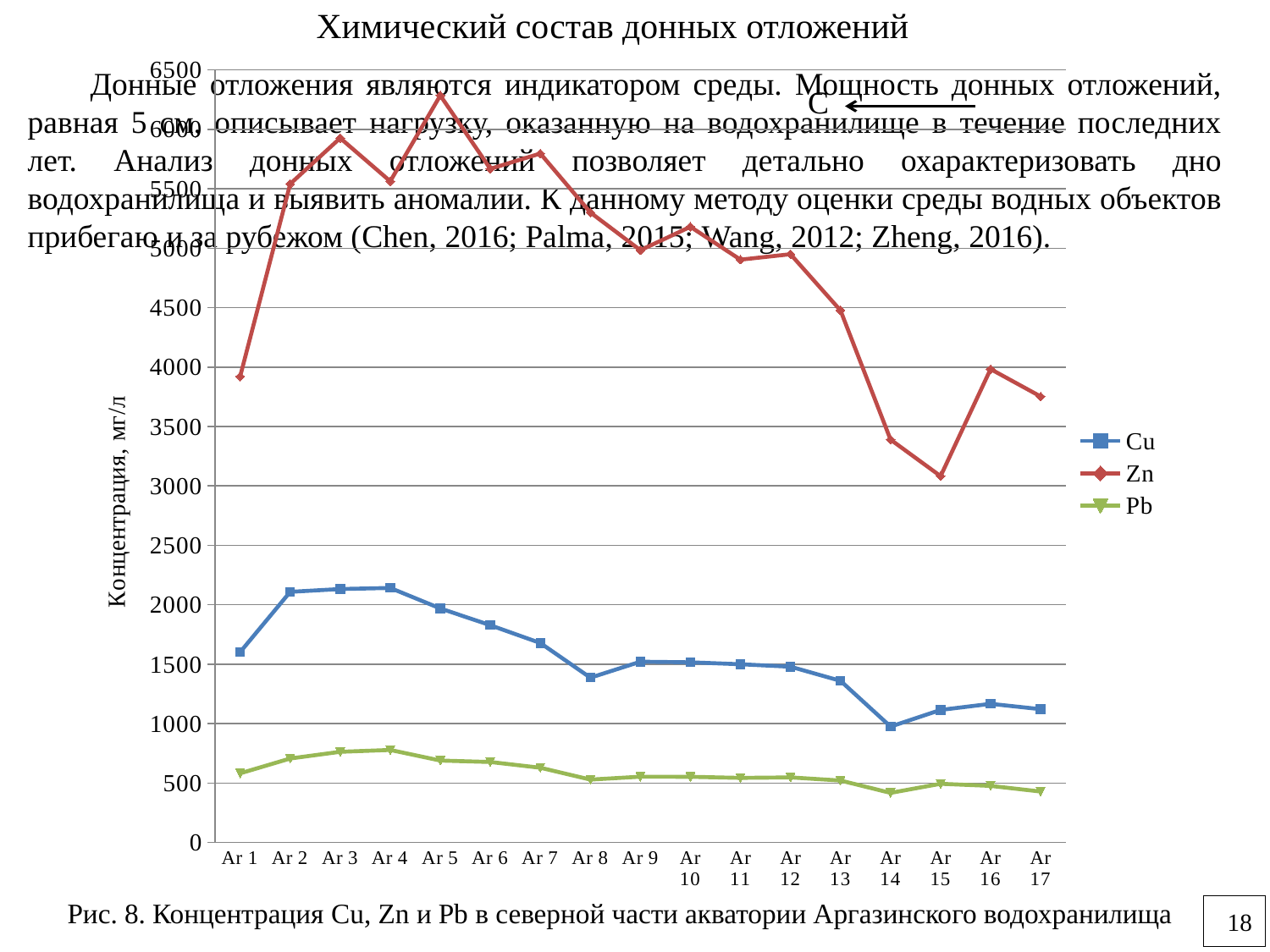
How many series does the legend list? 3 Which sampling point has the lowest Cu concentration? Ar 14 What is the label of the vertical axis? Концентрация, мг/л Which is larger, the Zn value for Ar 2 or the Zn value for Ar 14? Ar 2 How many sampling points (categories) are shown along the x axis? 17 Is the Cu value for Ar 8 greater or less than 1500? less What kind of chart is shown on the slide? line chart Is the Zn value for Ar 5 greater or less than 6000? greater Which sampling point has the lowest Zn concentration? Ar 15 Does the Cu concentration rise or fall from Ar 4 to Ar 8? fall Which sampling point has the highest Zn concentration? Ar 5 Is the Zn value for Ar 15 greater or less than 3500? less